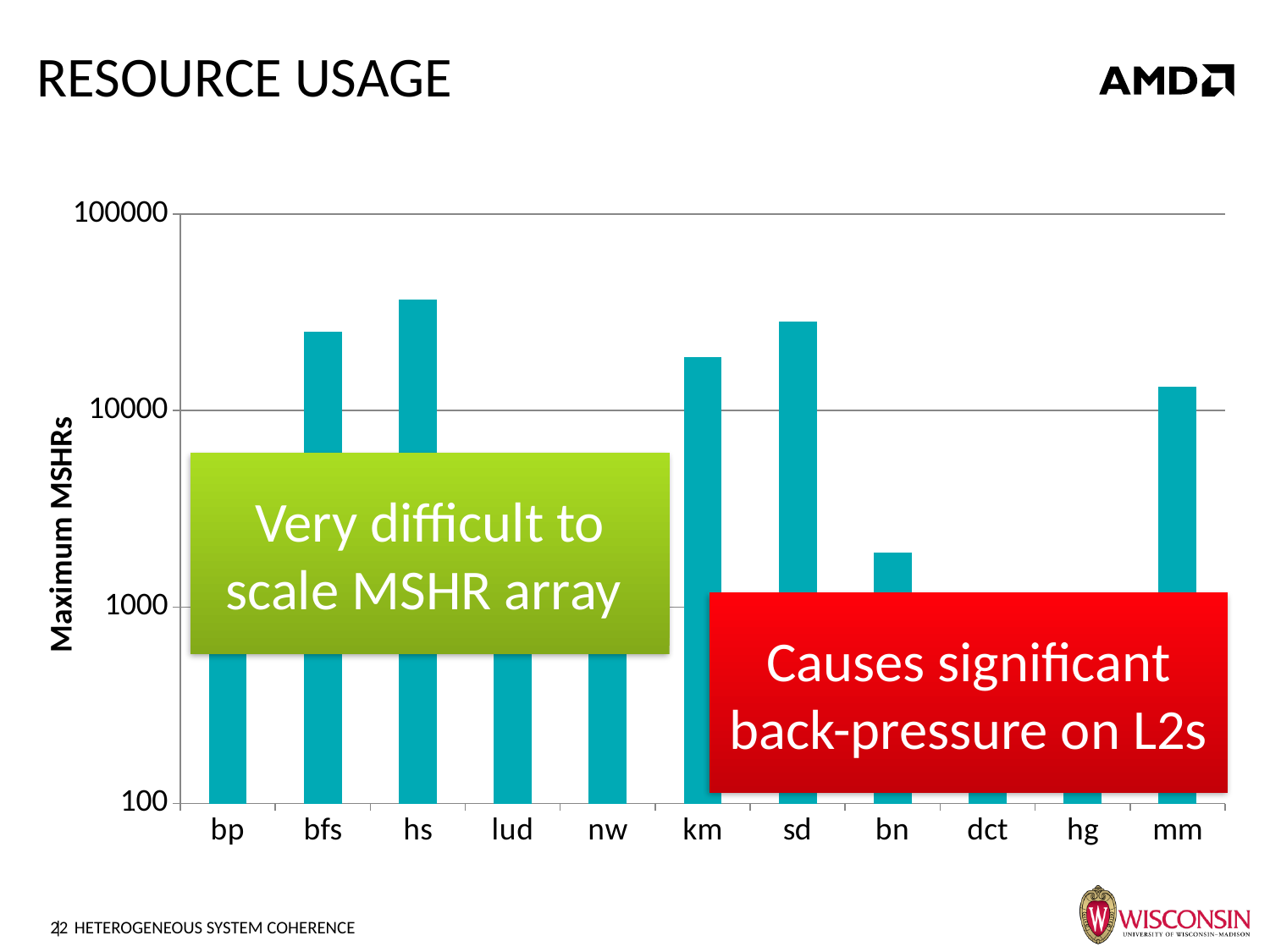
What does the green text box on the chart say? Very difficult to scale MSHR array Is the value for hs greater or less than 10000? greater What kind of chart is shown on the slide? bar chart Which has a larger Maximum MSHRs value, mm or bn? mm How many categories are shown on the x axis of the chart? 11 What is the label of the y axis? Maximum MSHRs Which has a larger Maximum MSHRs value, hs or sd? hs Is the value for bn greater or less than 10000? less Is the value for km greater or less than 10000? greater Which category has the highest Maximum MSHRs value? hs